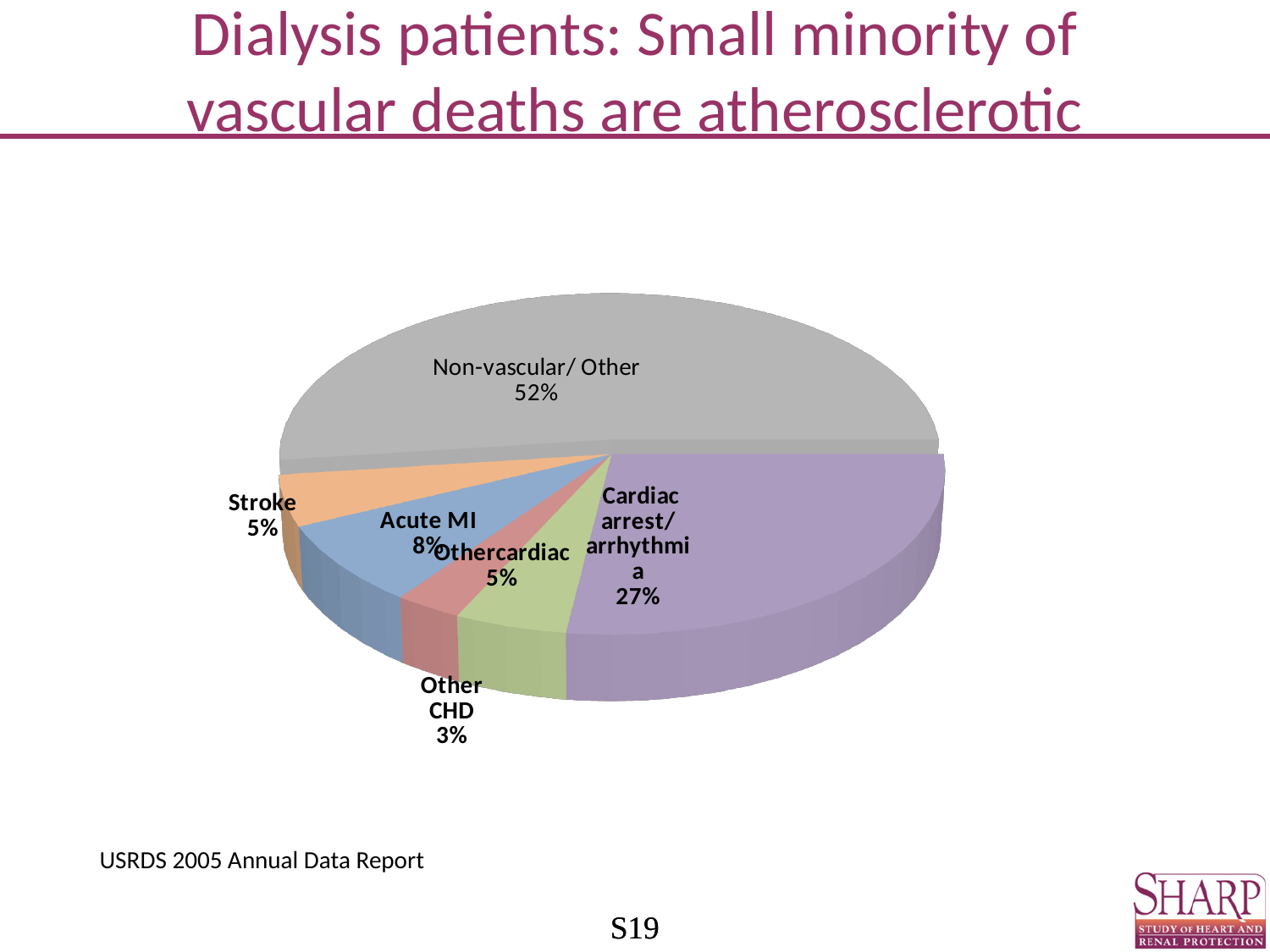
Which category has the largest share of the pie? Non-vascular/ Other Which is larger, the share for Acute MI or the share for Stroke? Acute MI What percentage of deaths is attributed to Acute MI? 8% How many slices does the pie chart have? 6 What percentage of deaths is attributed to Cardiac arrest/ arrhythmia? 27% What kind of chart is shown on the slide? Pie chart What is the difference in percentage points between Non-vascular/ Other and Cardiac arrest/ arrhythmia? 25 What percentage of deaths is labelled Non-vascular/ Other? 52% What percentage of deaths is attributed to Other CHD? 3% What percentage of deaths is attributed to Stroke? 5% What source is cited below the chart? USRDS 2005 Annual Data Report Which category has the smallest share of the pie? Other CHD